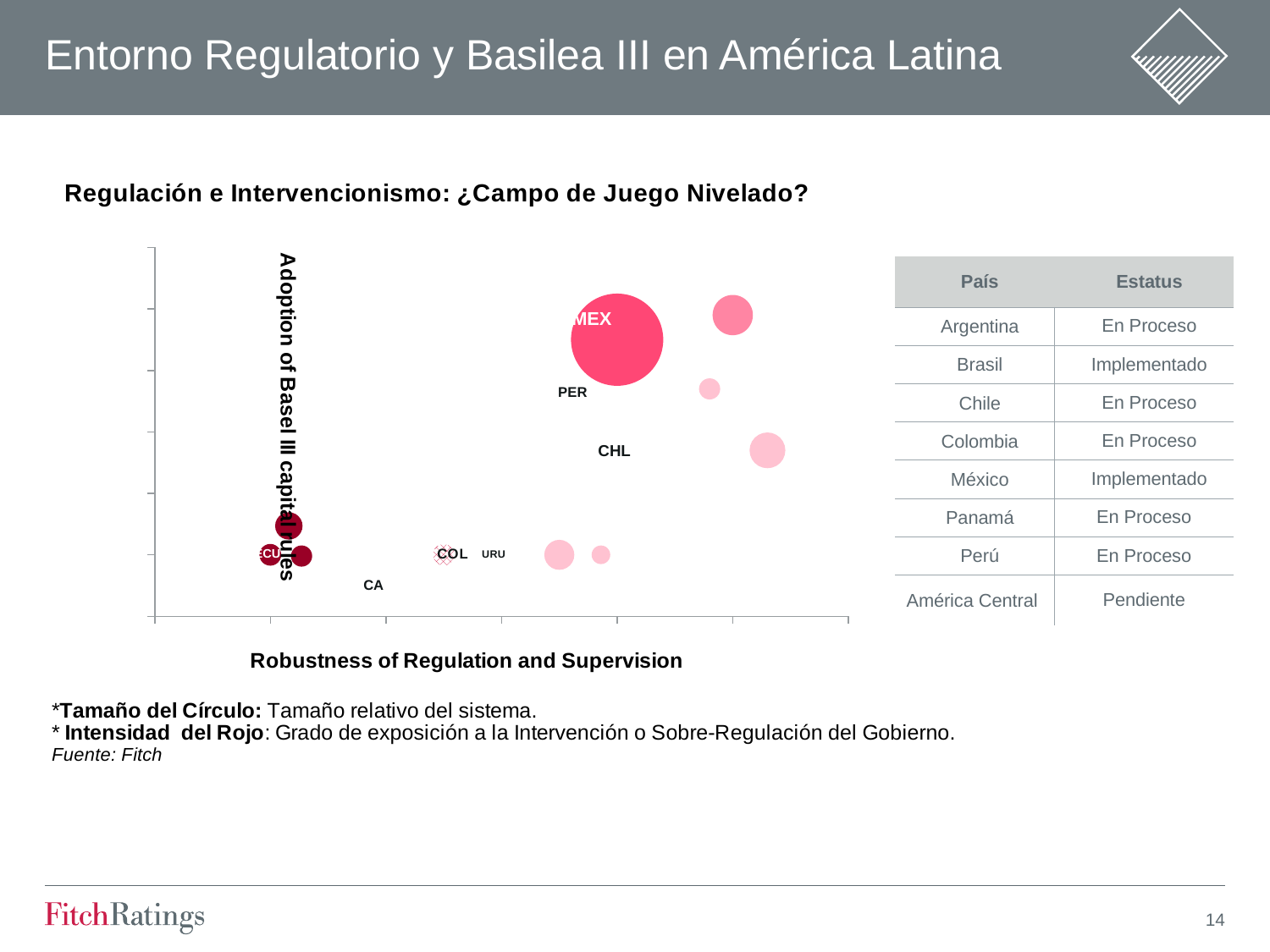
Which is positioned higher on the 'Adoption of Basel III capital rules' axis, MEX or COL? MEX What is the title of the horizontal axis of the chart? Robustness of Regulation and Supervision Which is positioned further to the right on the 'Robustness of Regulation and Supervision' axis, MEX or CA? MEX According to the note below the chart, what does the size of each circle represent? Tamaño relativo del sistema What kind of chart is shown on the slide? Bubble chart Which labeled country has the largest bubble in the chart? MEX Which labeled country is positioned highest on the 'Adoption of Basel III capital rules' axis? MEX Is the bubble for PER larger or smaller than the bubble for MEX? Smaller